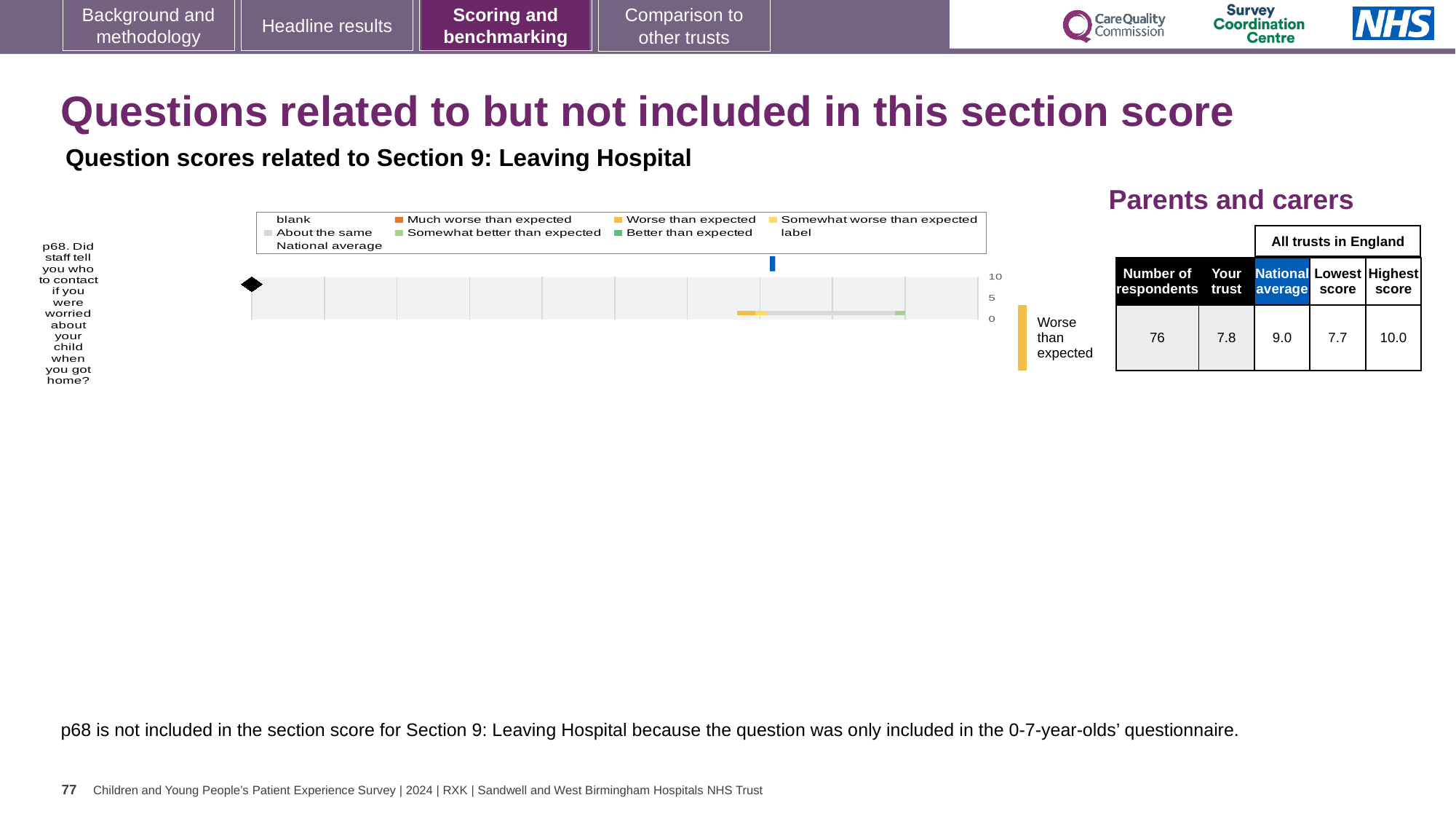
What is the national average score for question p68? 9.0 What is the lowest score among all trusts in England for question p68? 7.7 What is the difference between the highest and lowest trust scores for question p68? 2.3 What benchmark category is the trust's result for question p68 assigned to? Worse than expected What kind of chart is shown on the slide? Bar chart Which group of respondents does the chart on this slide cover? Parents and carers How many respondents answered question p68? 76 Which is larger for question p68: the trust's score or the national average? National average What is the score for 'Your trust' for question p68? 7.8 What is the highest score among all trusts in England for question p68? 10.0 How many questions are plotted on the chart? 1 What is the difference between the national average and the trust's score for question p68? 1.2